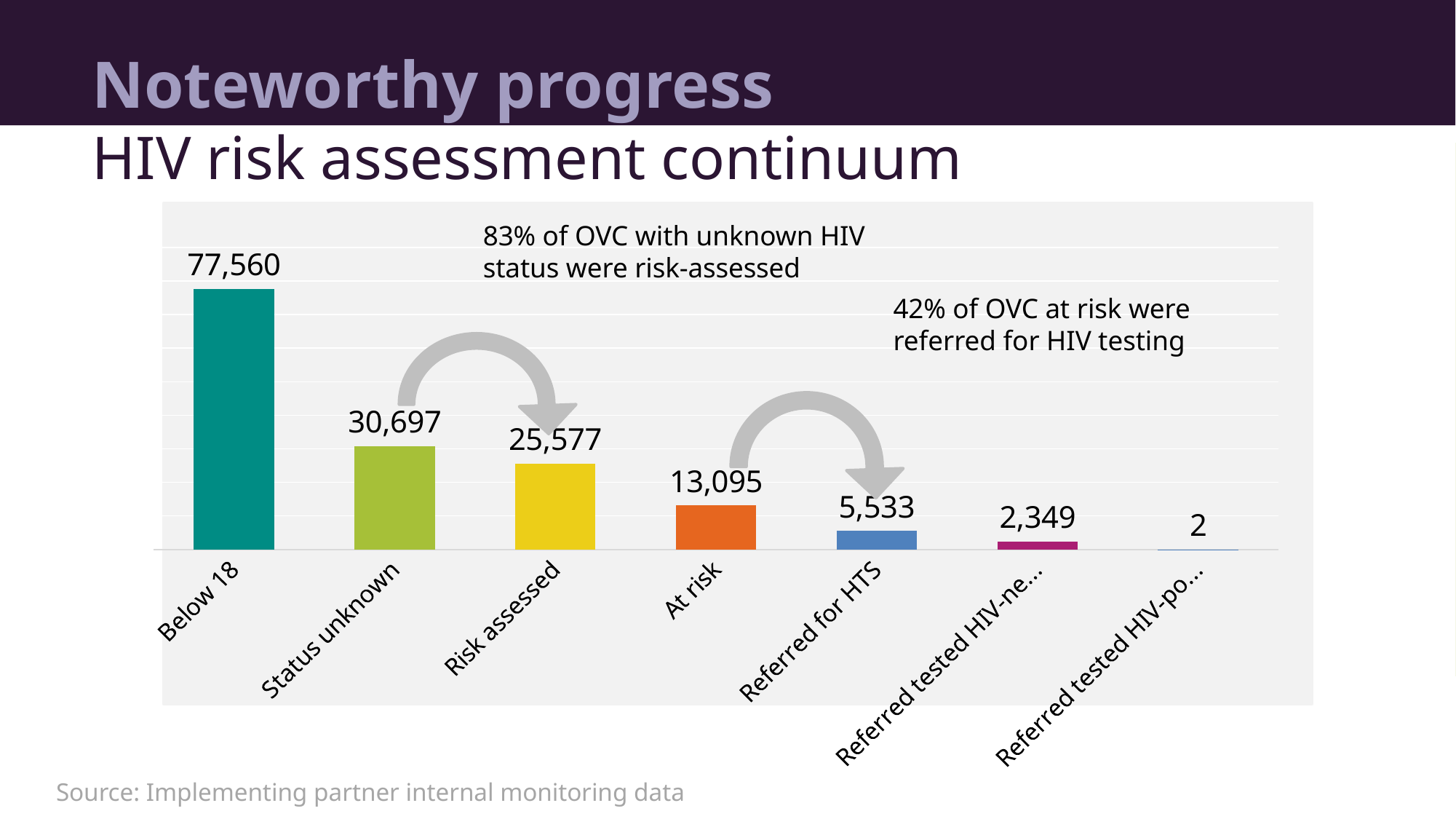
Which category has the highest value? Below 18 What is the value for At risk? 13,095 Which is larger, the value for Risk assessed or the value for At risk? Risk assessed What is the difference between the values for Status unknown and Risk assessed? 5,120 What kind of chart is shown on the slide? Bar chart What is the value for Status unknown? 30,697 How many categories are shown on the chart? 7 What is the value for Referred for HTS? 5,533 Do the values rise or fall from left to right along the x axis? Fall What is the value for Risk assessed? 25,577 What is the smallest value labelled on the chart? 2 What is the value for Below 18? 77,560